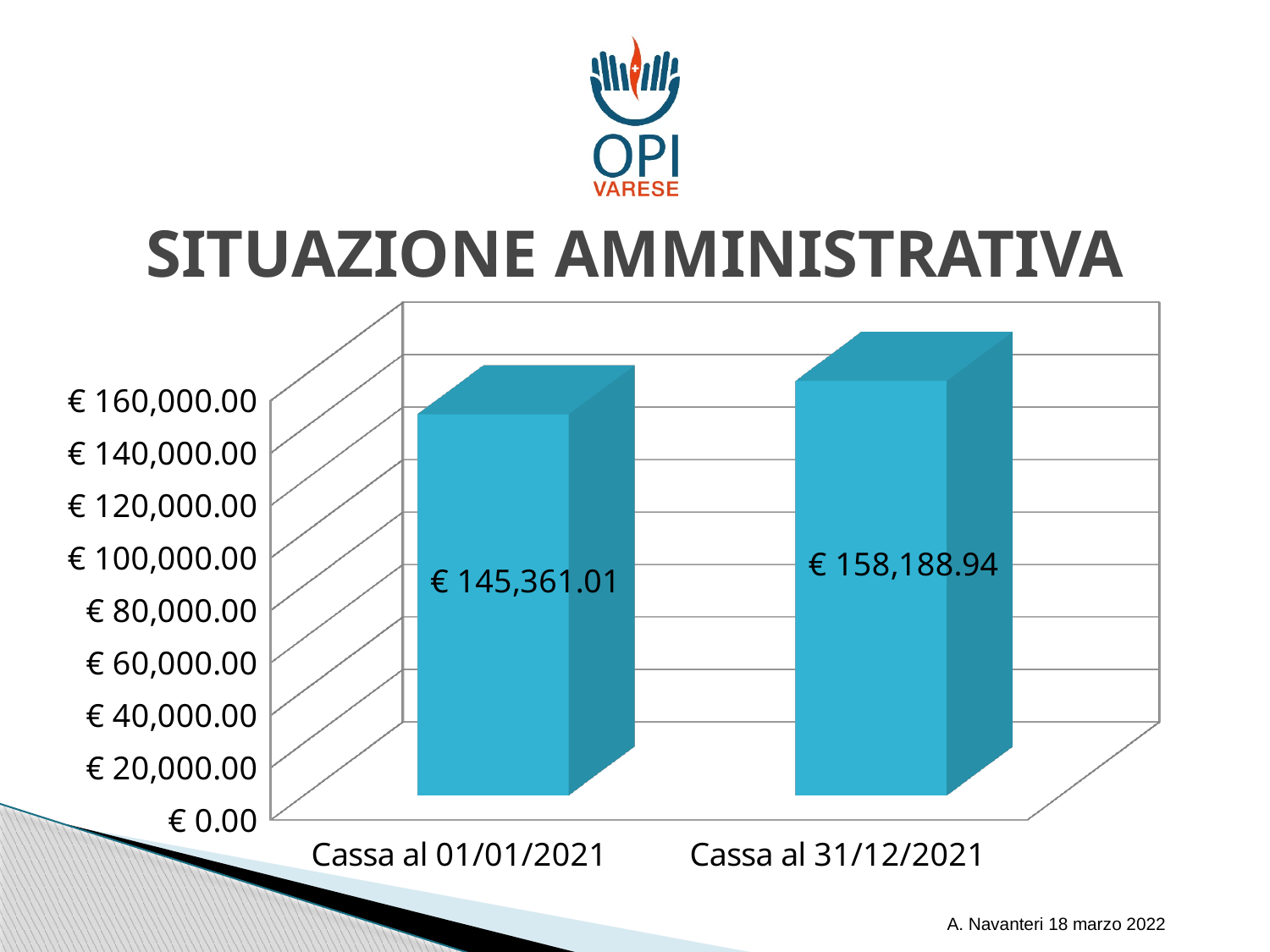
What is the title shown above the chart? SITUAZIONE AMMINISTRATIVA Which category has the highest value? Cassa al 31/12/2021 How many categories are shown on the chart? 2 Which category has the lowest value? Cassa al 01/01/2021 What is the difference between the value for Cassa al 31/12/2021 and the value for Cassa al 01/01/2021? € 12,827.93 Which is larger, the value for Cassa al 01/01/2021 or the value for Cassa al 31/12/2021? Cassa al 31/12/2021 What kind of chart is shown on the slide? bar chart What is the value for Cassa al 01/01/2021? € 145,361.01 Is the value for Cassa al 01/01/2021 greater or less than € 140,000.00? greater What is the value for Cassa al 31/12/2021? € 158,188.94 Do the values rise or fall from Cassa al 01/01/2021 to Cassa al 31/12/2021? rise Is the value for Cassa al 31/12/2021 greater or less than € 160,000.00? less